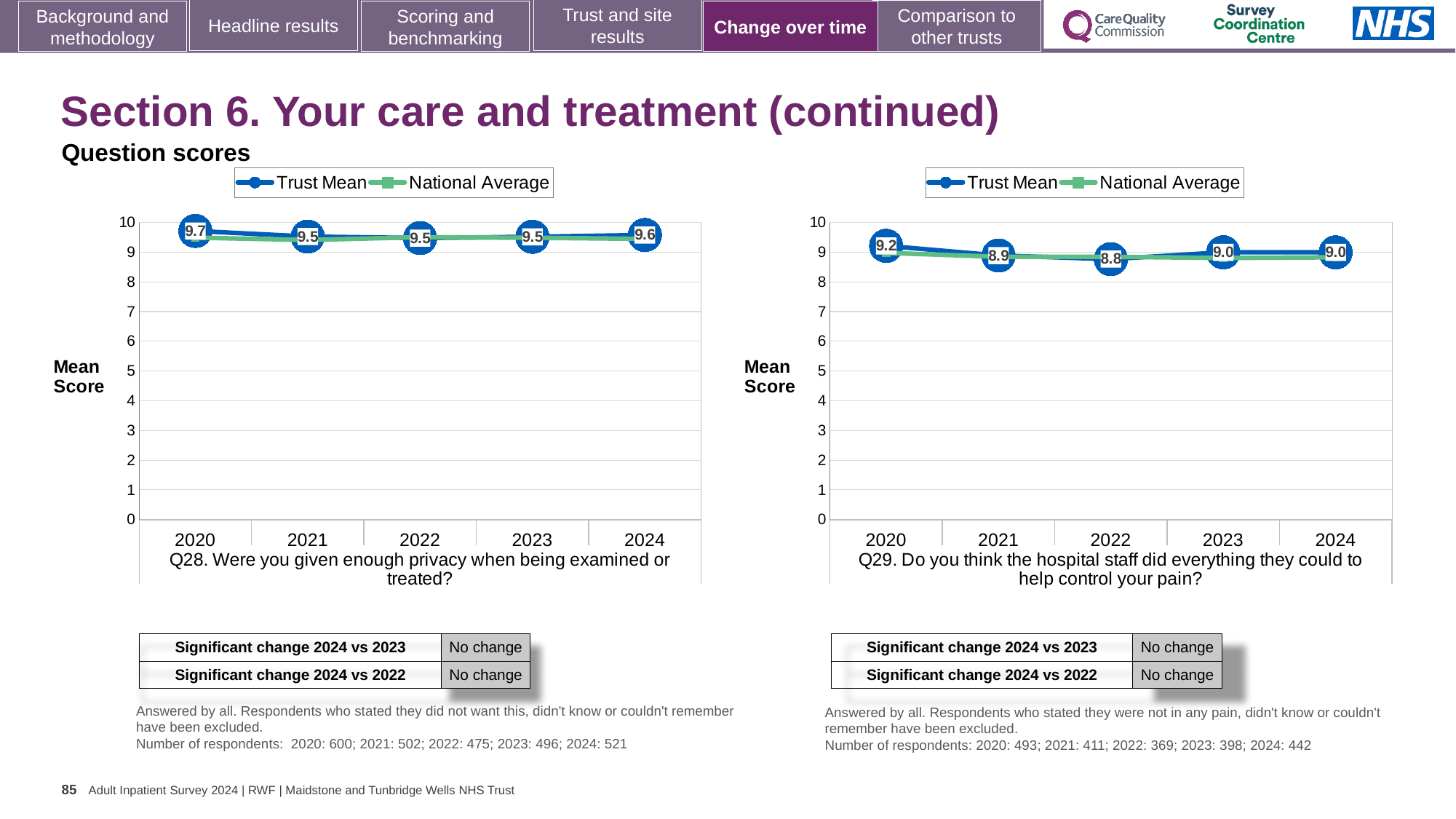
In the Q29 chart (right), which year has the lowest Trust Mean score? 2022 In the Q28 chart (left), what is the Trust Mean score for 2020? 9.7 What kind of chart is the Q28 chart (left)? Line chart In the Q29 chart (right), what is the difference between the Trust Mean scores for 2020 and 2022? 0.4 How many years are plotted on the x axis of the Q28 chart (left)? 5 In the Q28 chart (left), what is the Trust Mean score for 2024? 9.6 In the Q28 chart (left), which year has the highest Trust Mean score? 2020 In the Q28 chart (left), is the Trust Mean score for 2020 or 2024 higher? 2020 In the Q29 chart (right), what is the Trust Mean score for 2020? 9.2 How many series does the legend of the Q29 chart (right) list? 2 In the Q29 chart (right), is the Trust Mean value for 2021 greater or less than 8? greater In the Q29 chart (right), what is the Trust Mean score for 2022? 8.8